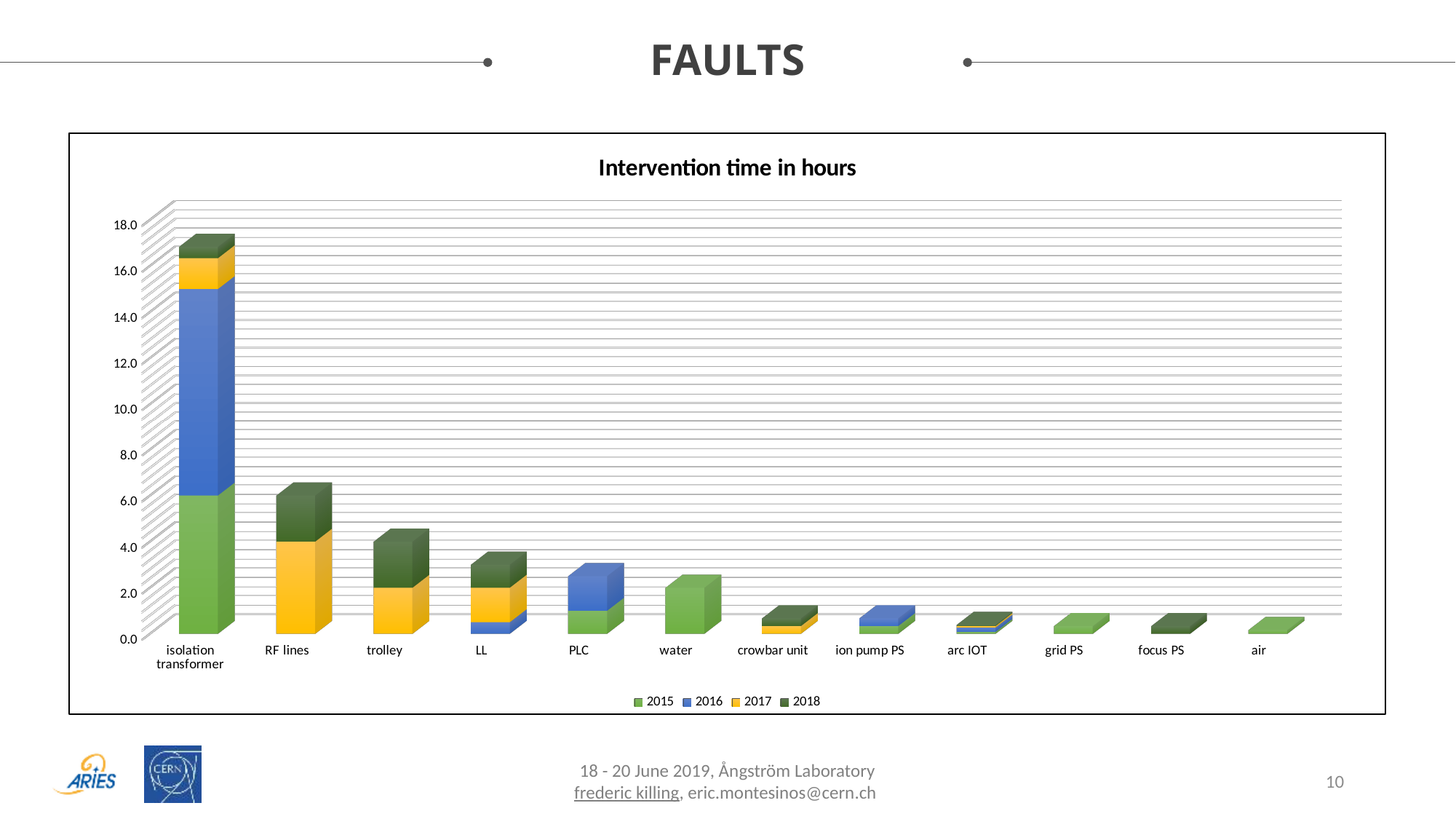
Is the total intervention time for crowbar unit greater or less than 2.0? less Which fault category has the highest total intervention time? isolation transformer Which has the larger total intervention time, isolation transformer or trolley? isolation transformer What kind of chart is shown on the slide? Stacked bar chart What is the title of the chart? Intervention time in hours Which year does the yellow segment in the bars represent? 2017 Is the total intervention time for isolation transformer greater or less than 14.0? greater How many fault categories are shown on the x axis? 12 Is the total intervention time for RF lines greater or less than 4.0? greater How many series does the legend list? 4 Which has the larger total intervention time, RF lines or water? RF lines